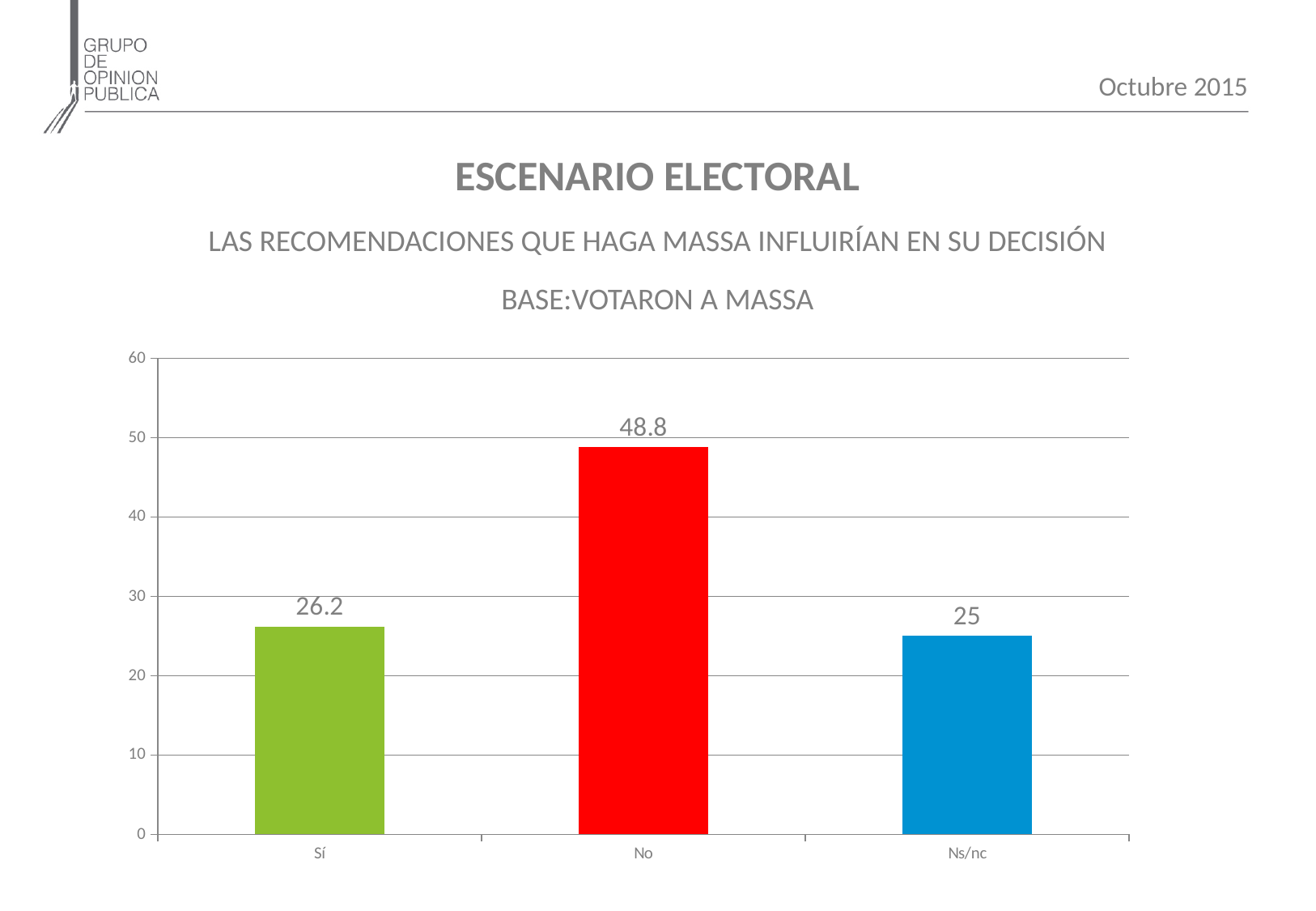
What colour is the bar for "No"? red What is the value for "Sí"? 26.2 Which category has the lowest value? Ns/nc What is the value for "Ns/nc"? 25 What is the difference between the values for "No" and "Sí"? 22.6 What is the difference between the values for "Sí" and "Ns/nc"? 1.2 What kind of chart is shown on the slide? bar chart Which category has the highest value? No How many categories are shown on the x axis? 3 What is the value for "No"? 48.8 Is the value for "No" greater or less than 40? greater Which is larger, the value for "No" or the value for "Ns/nc"? No